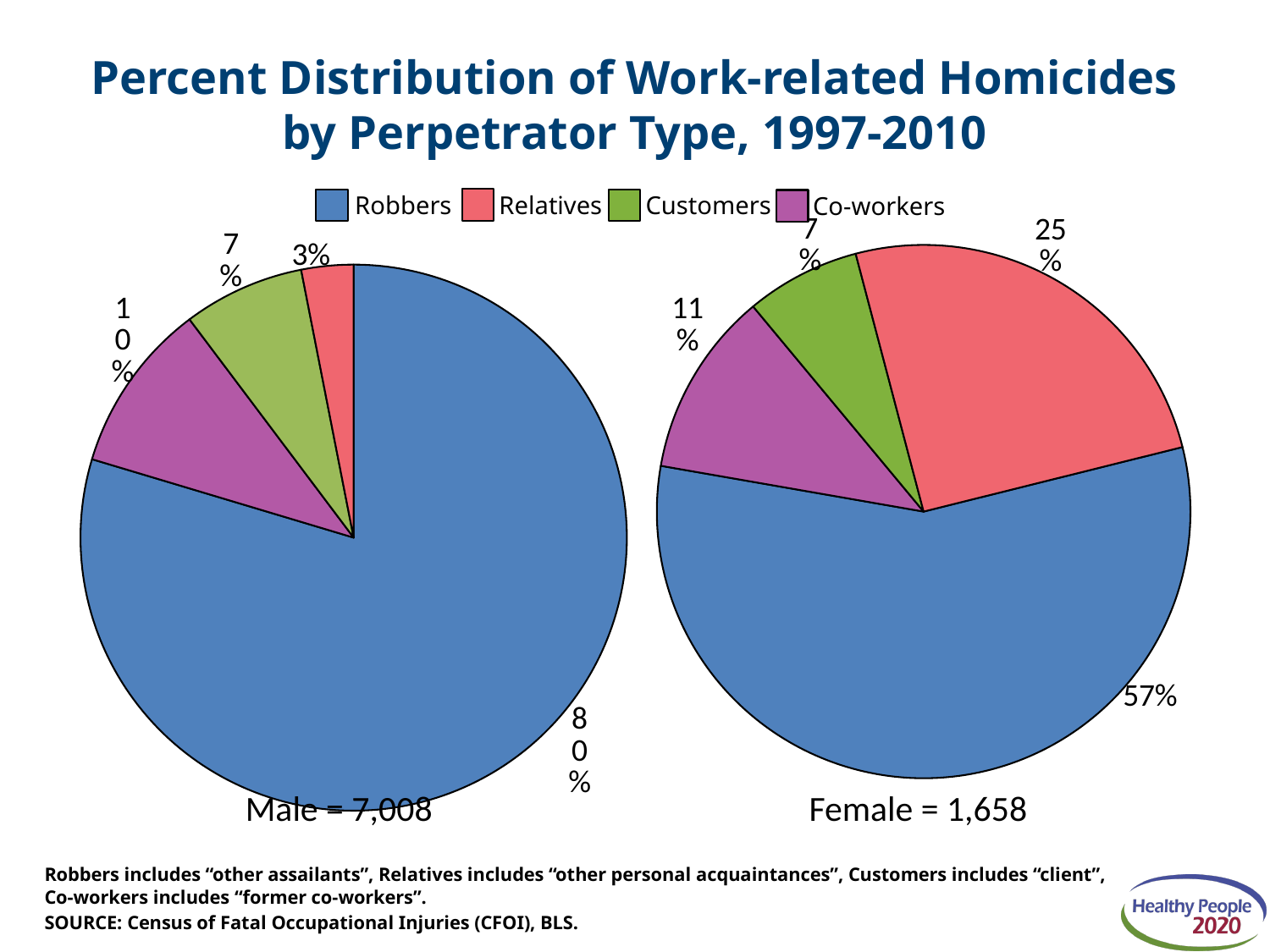
In the Male pie chart, which perpetrator type has the smallest share? Relatives Which colour represents Customers in the pie charts? green What is the difference between the Robbers share in the Male pie chart and the Robbers share in the Female pie chart? 23 percentage points In the Male pie chart, what percentage is shown for Relatives? 3% In the Female pie chart, which perpetrator type has the largest share? Robbers What type of chart is used on this slide? pie chart Is the Co-workers share larger in the Male pie chart or the Female pie chart? Female In the Female pie chart, what percentage is shown for Co-workers? 11% In the Male pie chart, what percentage of work-related homicides were committed by Robbers? 80% In the Female pie chart, what percentage of work-related homicides were committed by Relatives? 25% What is the total number of work-related homicides shown for the Male pie chart? 7,008 How many perpetrator types does the legend list? 4